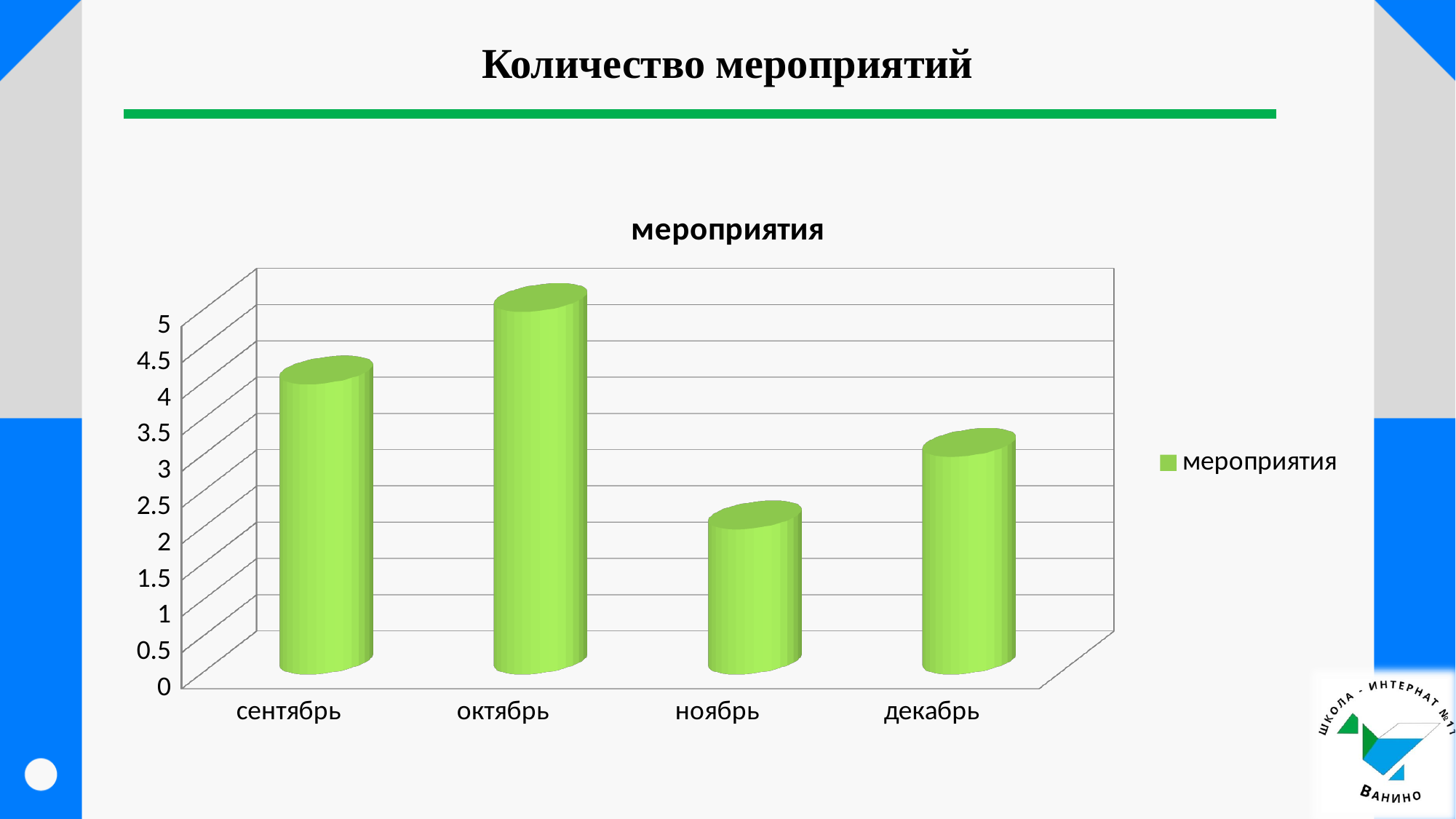
How many categories are shown on the x axis of the chart? 4 Is the value for октябрь greater or less than 4? greater Which is larger, the value for ноябрь or the value for декабрь? декабрь Which month has the lowest value in the chart? ноябрь How many series does the legend list? 1 Is the value for ноябрь greater or less than 3? less Which is larger, the value for сентябрь or the value for декабрь? сентябрь Is the value for декабрь greater or less than 4? less What kind of chart is shown on the slide? bar chart Which month has the highest value in the chart? октябрь What is the name of the series shown in the legend? мероприятия